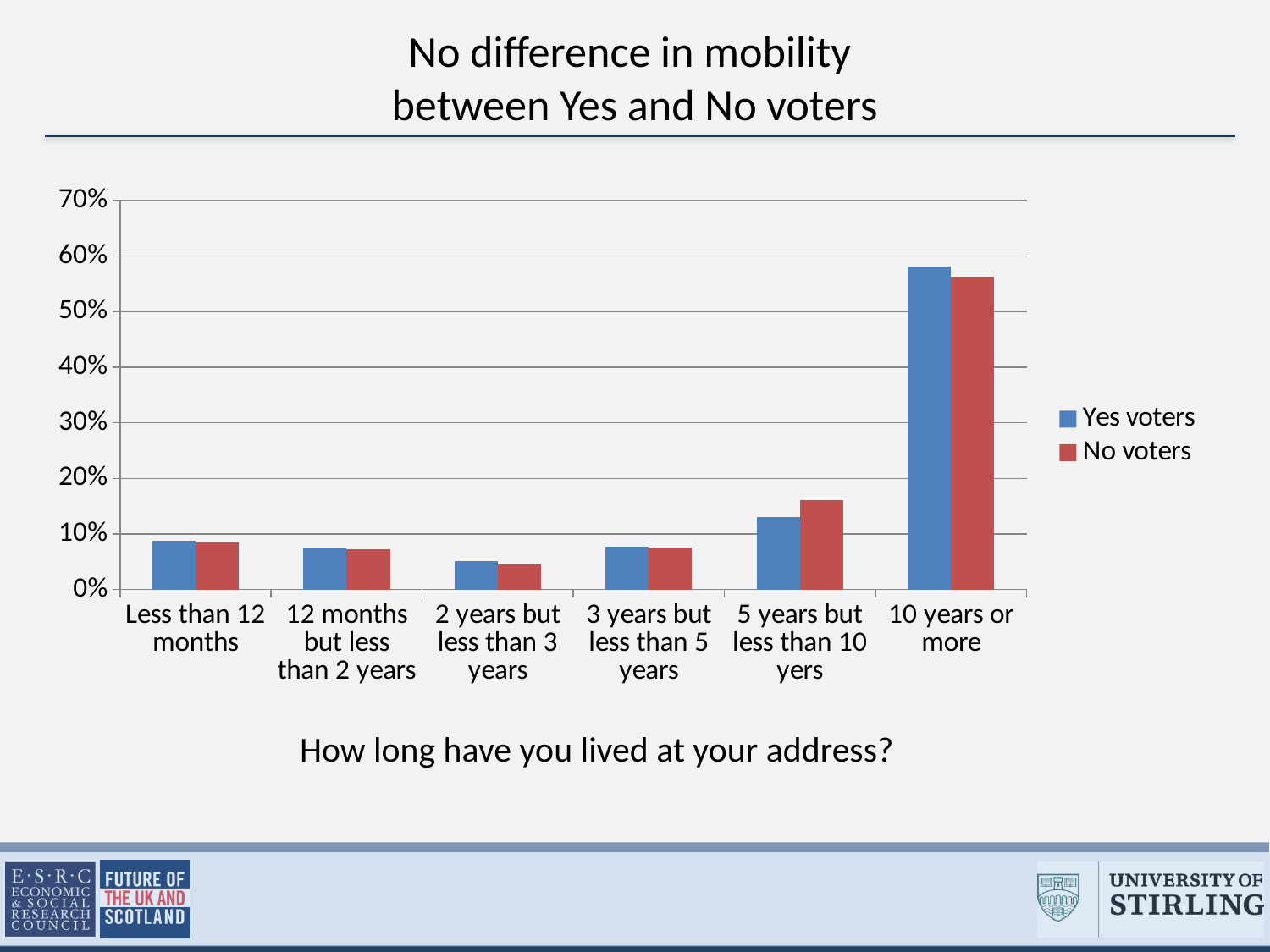
Which category has the lowest value for Yes voters? 2 years but less than 3 years How many categories are shown on the x axis? 6 Which category has the highest value for Yes voters? 10 years or more What kind of chart is shown on the slide? bar chart Is the value for Yes voters in the 'Less than 12 months' category greater or less than 10%? less Is the value for Yes voters in the '10 years or more' category greater or less than 50%? greater Which category has the highest value for No voters? 10 years or more In the '5 years but less than 10 yers' category, which series has the larger value, Yes voters or No voters? No voters What colour are the bars for No voters? red What is the title of the chart? No difference in mobility between Yes and No voters Is the value for No voters in the '5 years but less than 10 yers' category greater or less than 10%? greater How many series does the legend list? 2